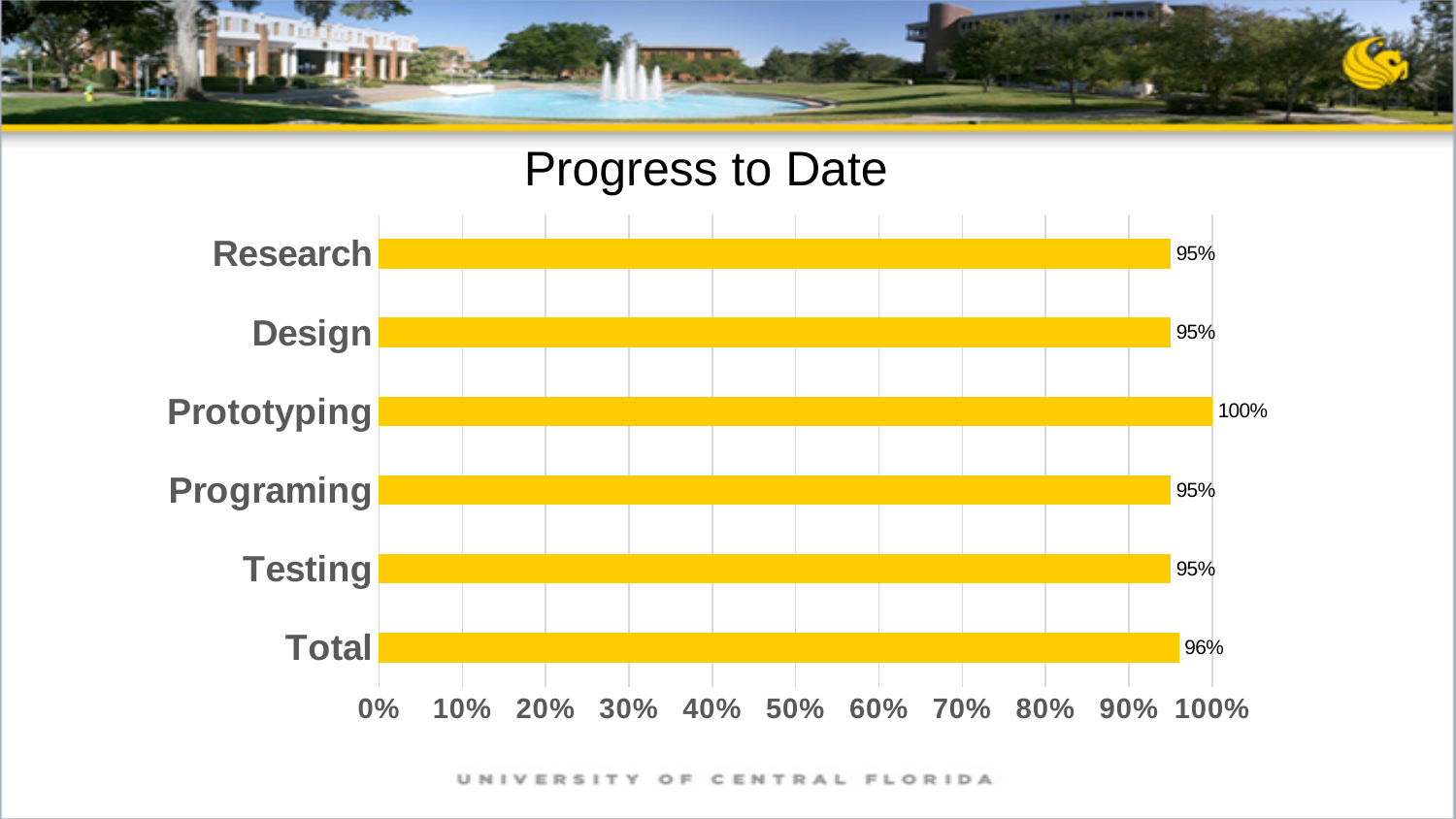
What is the value for Total? 96% Which category has the highest value? Prototyping What is the value for Prototyping? 100% Which is larger, the value for Prototyping or the value for Total? Prototyping What kind of chart is shown on the slide? Bar chart What is the title of the chart? Progress to Date What is the value for Research? 95% What is the difference between the values for Total and Programing? 1% How many categories are shown in the chart? 6 What is the difference between the values for Prototyping and Design? 5% Is the value for Design greater or less than 90%? greater What is the value for Testing? 95%